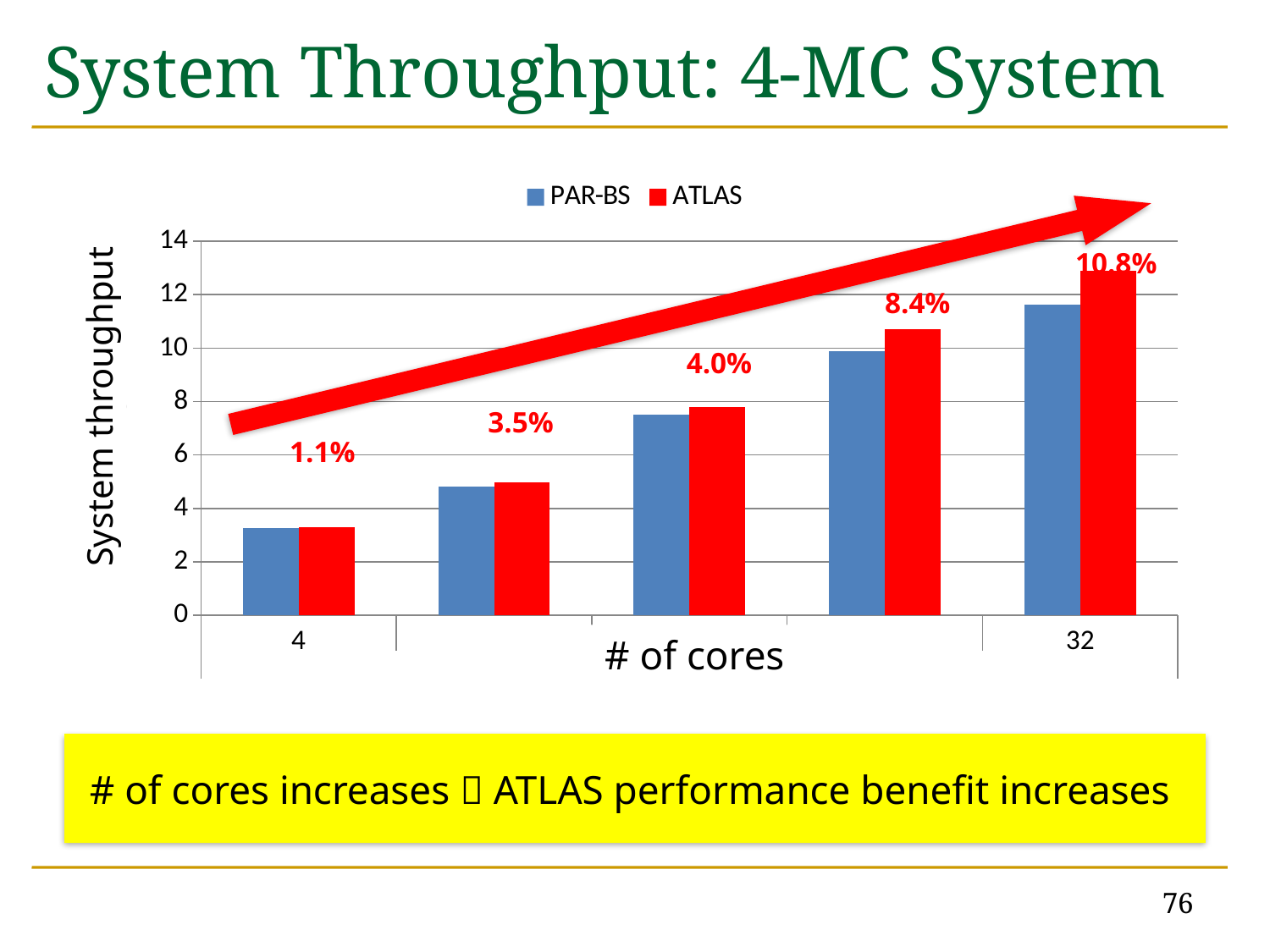
Is the PAR-BS system throughput for 4 cores greater or less than 4? less Do the system throughput values rise or fall as the number of cores increases along the x axis? rise Which two series are listed in the legend? PAR-BS and ATLAS What percentage improvement is printed above the bars for 4 cores? 1.1% What percentage improvement is printed above the bars for 32 cores? 10.8% How many groups of bars (core counts) are plotted on the x axis? 5 Is the PAR-BS system throughput for 32 cores greater or less than 10? greater What is the title of the y axis? System throughput How many series does the legend list? 2 What kind of chart is shown on the slide? bar chart At 32 cores, which series has the higher system throughput, PAR-BS or ATLAS? ATLAS Is the ATLAS system throughput for 32 cores greater or less than 12? greater